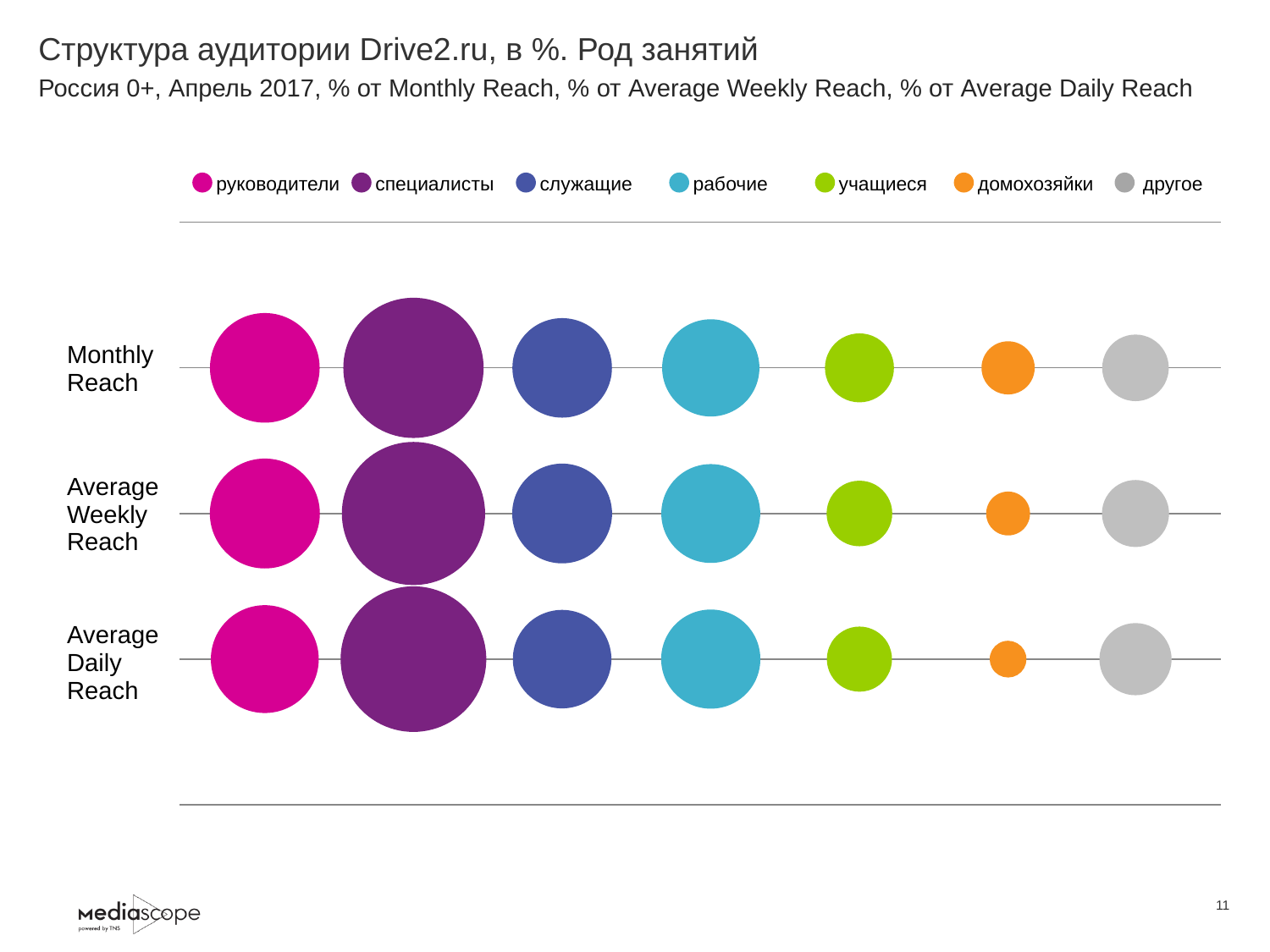
What is the title of the chart on the slide? Структура аудитории Drive2.ru, в %. Род занятий Which occupation group has the smallest bubble in the Average Daily Reach row? домохозяйки In the Average Weekly Reach row, which bubble is larger: руководители or учащиеся? руководители In the Average Daily Reach row, which bubble is larger: домохозяйки or другое? другое How many occupation groups does the legend list? 7 In the Monthly Reach row, which bubble is larger: специалисты or служащие? специалисты Which occupation group has the largest bubble in the Monthly Reach row? специалисты Which occupation group is shown in orange in the legend? домохозяйки What kind of chart is shown on the slide? bubble chart Which occupation group has the smallest bubble in the Monthly Reach row? домохозяйки How many reach rows (categories) are plotted on the chart? 3